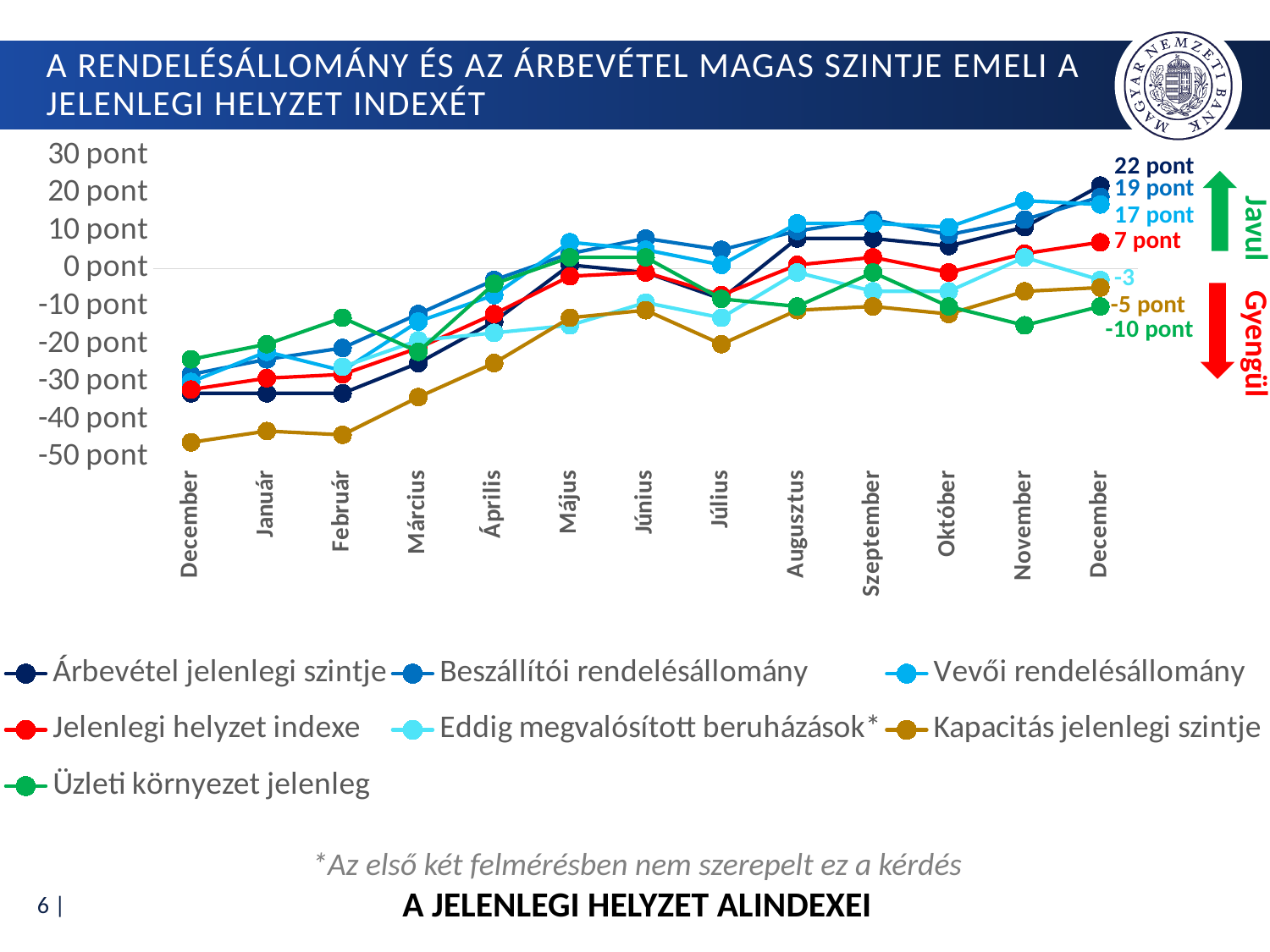
Which series has the lowest value in the final December? Üzleti környezet jelenleg What is the difference between Árbevétel jelenlegi szintje and Jelenlegi helyzet indexe in the final December? 15 pont How many series does the legend list? 7 What is the value of Kapacitás jelenlegi szintje in the final December? -5 pont What is the value of Árbevétel jelenlegi szintje in the final December? 22 pont What kind of chart is shown on the slide? line chart What is the value of Jelenlegi helyzet indexe in the final December? 7 pont Which series has the highest value in the final December? Árbevétel jelenlegi szintje Is the value for Kapacitás jelenlegi szintje in the first December greater or less than -40 pont? less What is the value of Üzleti környezet jelenleg in the final December? -10 pont How many months are shown along the x axis? 13 In the final December, which is larger: Beszállítói rendelésállomány or Vevői rendelésállomány? Beszállítói rendelésállomány